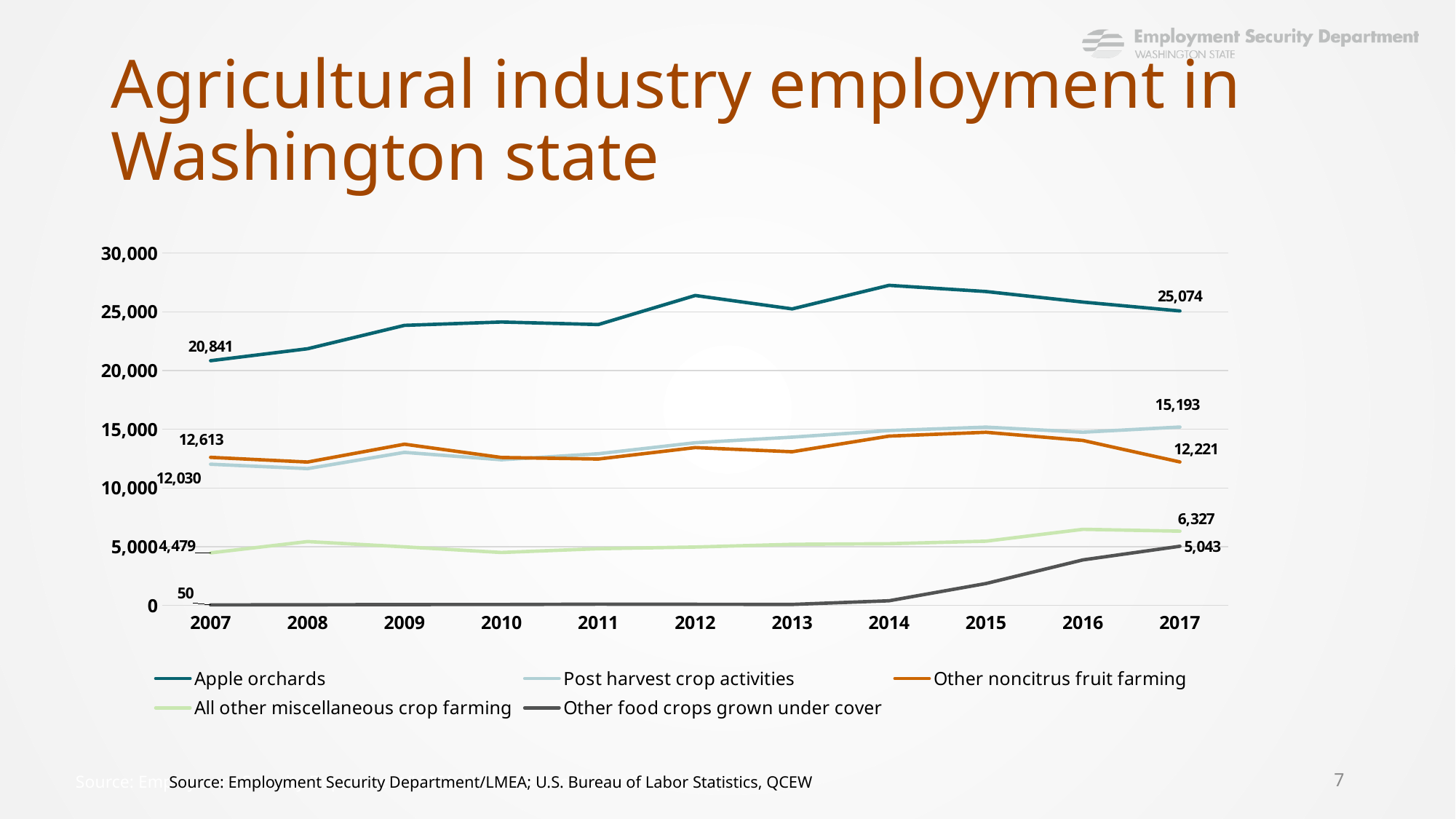
How many series does the legend list? 5 By how much did Apple orchards employment increase from 2007 to 2017? 4,233 What is the value for Other noncitrus fruit farming in 2007? 12,613 What is the value for Post harvest crop activities in 2017? 15,193 Which series has the highest value in 2017? Apple orchards Which series has the lowest value in 2007? Other food crops grown under cover What is the difference between the 2017 and 2007 values for Other food crops grown under cover? 4,993 In 2017, which is larger: Post harvest crop activities or Other noncitrus fruit farming? Post harvest crop activities How many years are shown on the x axis? 11 Is the value for Apple orchards in 2014 greater or less than 25,000? greater What is the value for Apple orchards in 2017? 25,074 What is the value for Other food crops grown under cover in 2007? 50